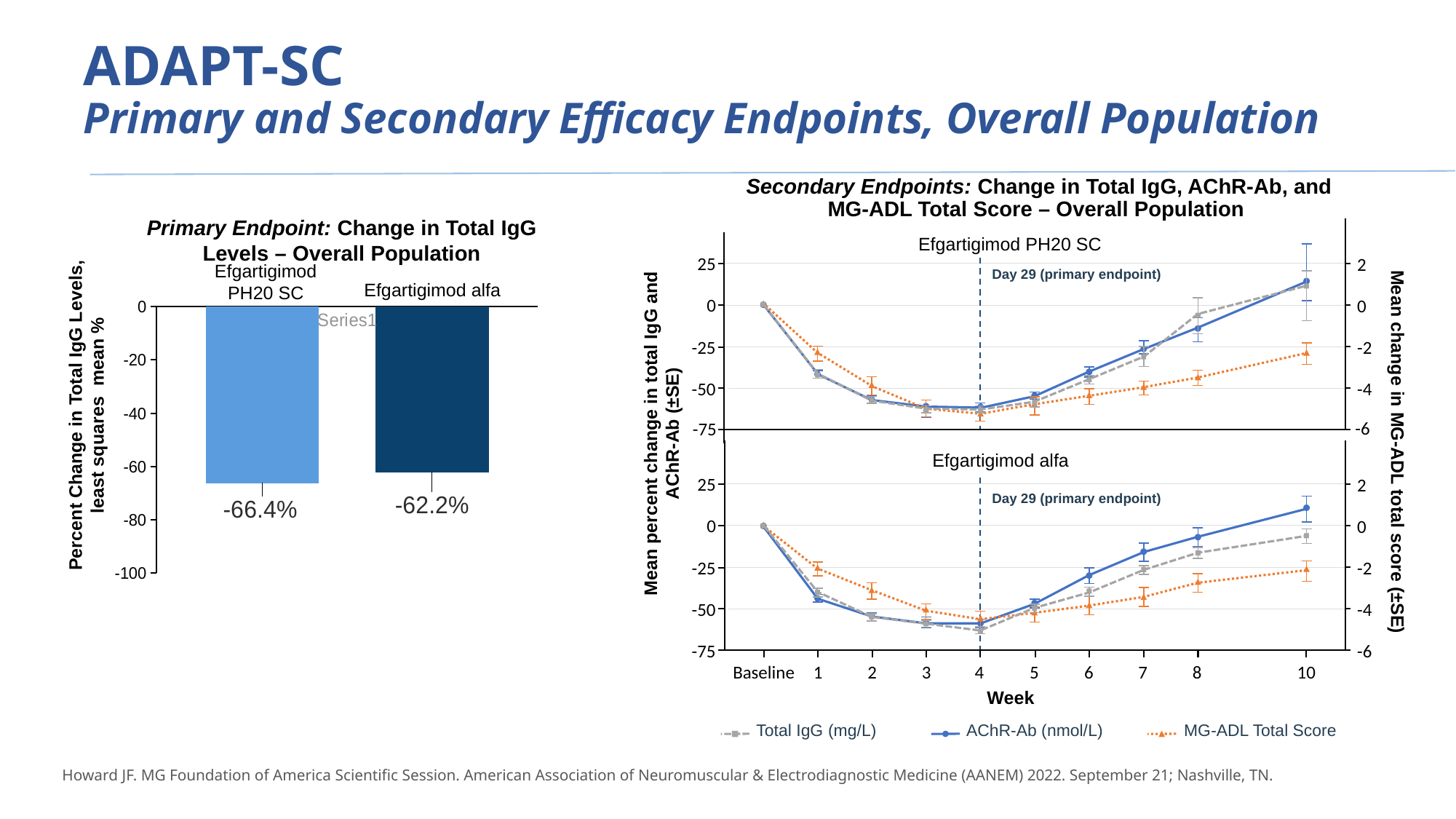
What type of chart is used for the Secondary Endpoints on the right? Line chart What type of chart is the Primary Endpoint chart on the left? Bar chart In the Primary Endpoint bar chart, what is the percent change in total IgG levels for Efgartigimod alfa? -62.2% How many series does the legend of the Secondary Endpoints chart list? 3 In the Primary Endpoint bar chart, what is the difference in percentage points between the two bars? 4.2 percentage points In the Secondary Endpoints chart, at which week is the dashed vertical line labelled 'Day 29 (primary endpoint)' placed? Week 4 In the Primary Endpoint bar chart, what is the percent change in total IgG levels for Efgartigimod PH20 SC? -66.4% In the Secondary Endpoints chart, how many time points are labelled on the Week axis? 10 How many bars are shown in the Primary Endpoint chart? 2 In the Primary Endpoint bar chart, which treatment shows the larger reduction in total IgG levels? Efgartigimod PH20 SC In the Efgartigimod PH20 SC panel of the Secondary Endpoints chart, is the Total IgG value at Week 10 greater or less than 0? greater In the Secondary Endpoints chart, how do the values change from Baseline to Week 4 and then from Week 4 to Week 10? They fall from Baseline to Week 4, then rise to Week 10